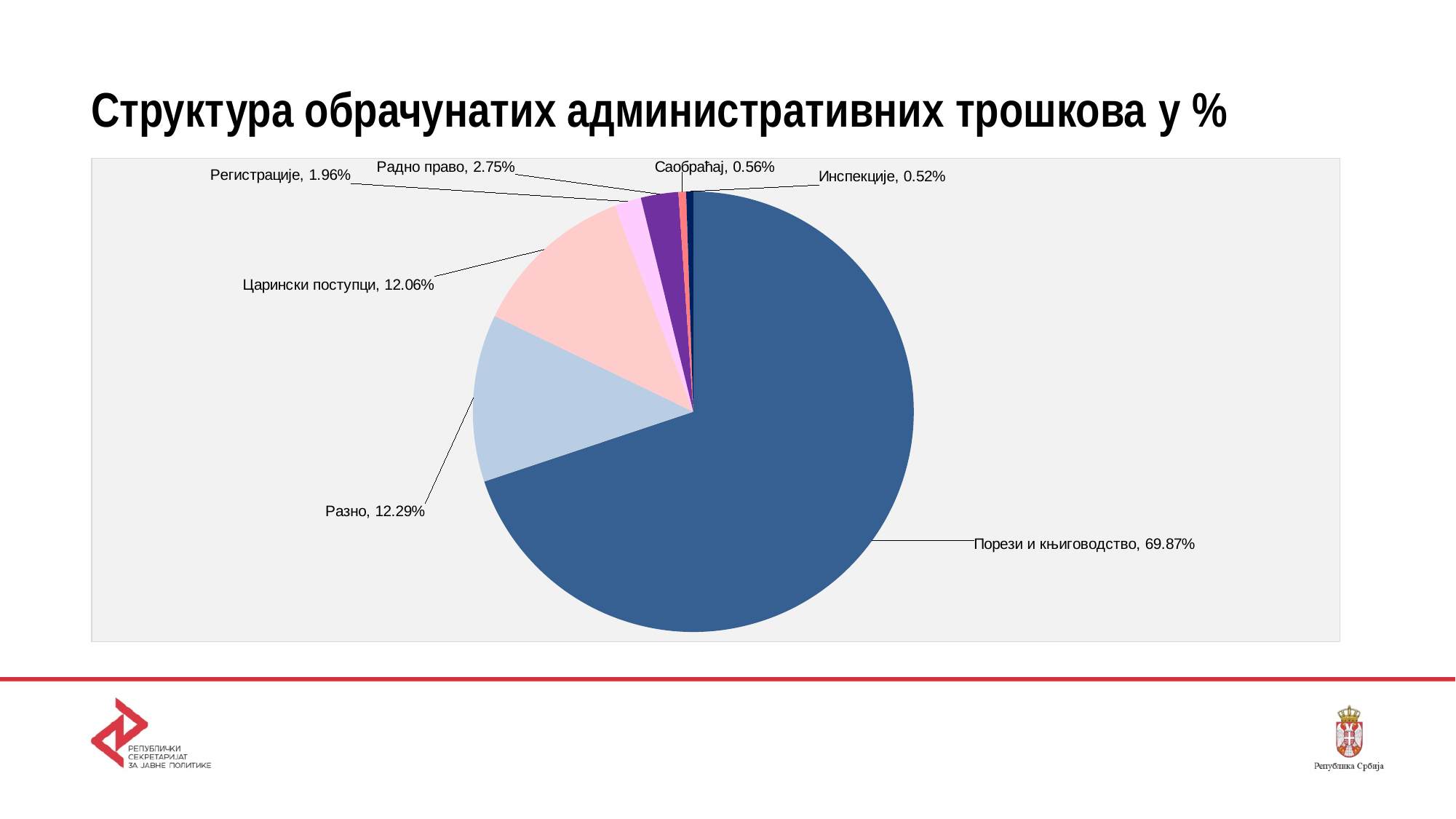
Which category has the smallest slice of the pie? Инспекције What percentage is shown for Радно право? 2.75% How many slices does the pie chart have? 7 Which is larger, the share for Разно or the share for Царински поступци? Разно What is the value for Инспекције? 0.52% What share of the pie does Порези и књиговодство account for? 69.87% What is the difference between the shares of Радно право and Регистрације? 0.79% What is the value shown for Царински поступци? 12.06% Which category has the largest slice of the pie? Порези и књиговодство What is the difference between the shares of Порези и књиговодство and Разно? 57.58% What type of chart is shown on the slide? Pie chart What is the title of the slide? Структура обрачунатих административних трошкова у %